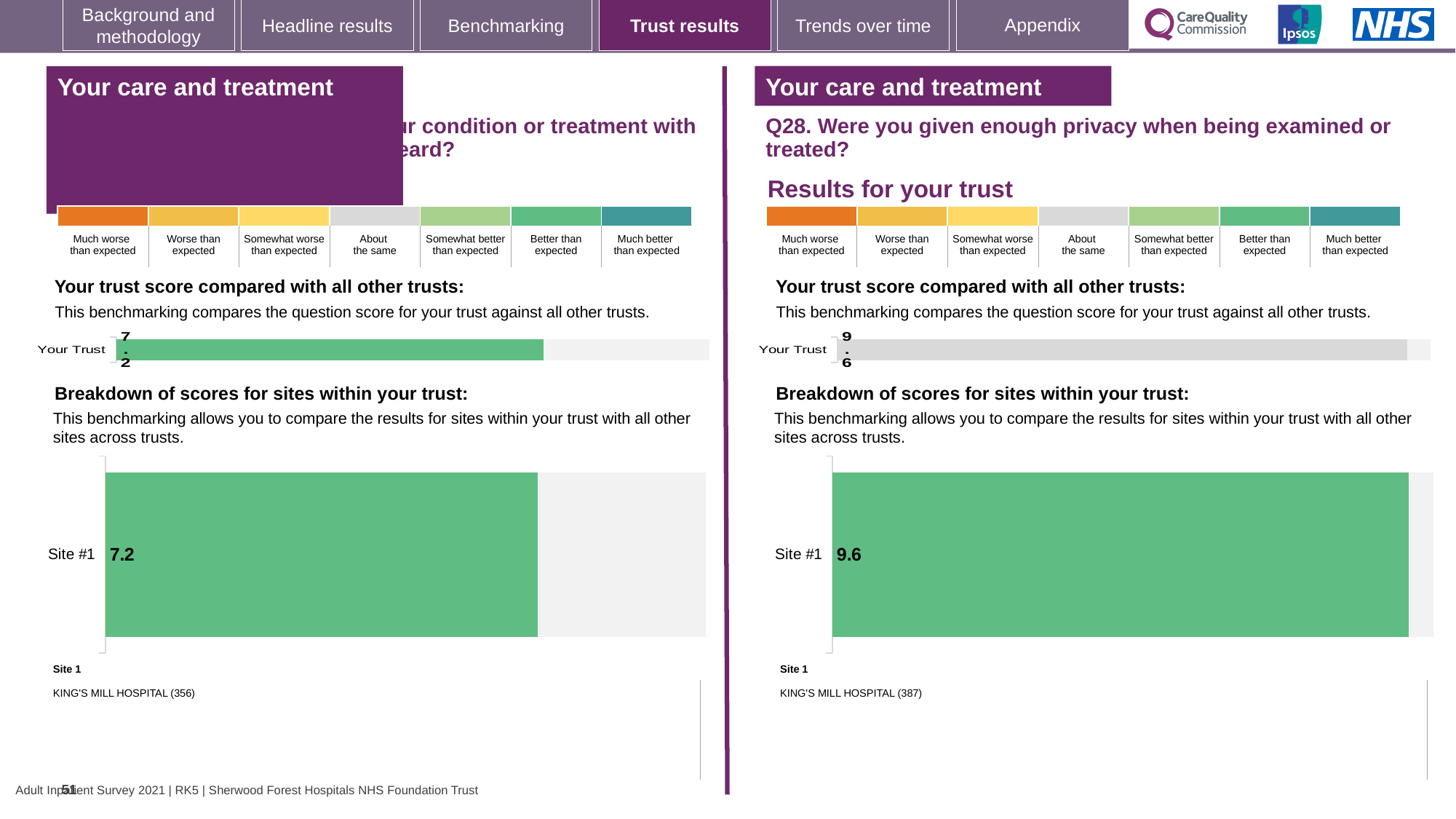
What is the difference between the Site #1 score in the right breakdown chart and the Site #1 score in the left breakdown chart? 2.4 What type of chart is used to show the Site #1 score on the right half of the slide? Bar chart Which hospital is listed as Site 1 beneath the right breakdown chart, and how many respondents are shown in brackets? KING'S MILL HOSPITAL (387) What is the difference between the 'Your Trust' score on the right half of the slide and the 'Your Trust' score on the left half? 2.4 What colour is the Site #1 bar in the left breakdown chart? Green On the left half of the slide, what is the 'Your Trust' score shown in the trust benchmarking bar? 7.2 On the right half of the slide (Q28), what is the 'Your Trust' score shown in the trust benchmarking bar? 9.6 How many sites are plotted in the right 'Breakdown of scores for sites within your trust' chart? 1 Which is larger: the Site #1 score in the left breakdown chart or the Site #1 score in the right breakdown chart? The right chart (9.6) How many sites are plotted in the left 'Breakdown of scores for sites within your trust' chart? 1 In the left 'Breakdown of scores for sites within your trust' chart, what is the score for Site #1? 7.2 In the right 'Breakdown of scores for sites within your trust' chart (Q28), what is the score for Site #1? 9.6